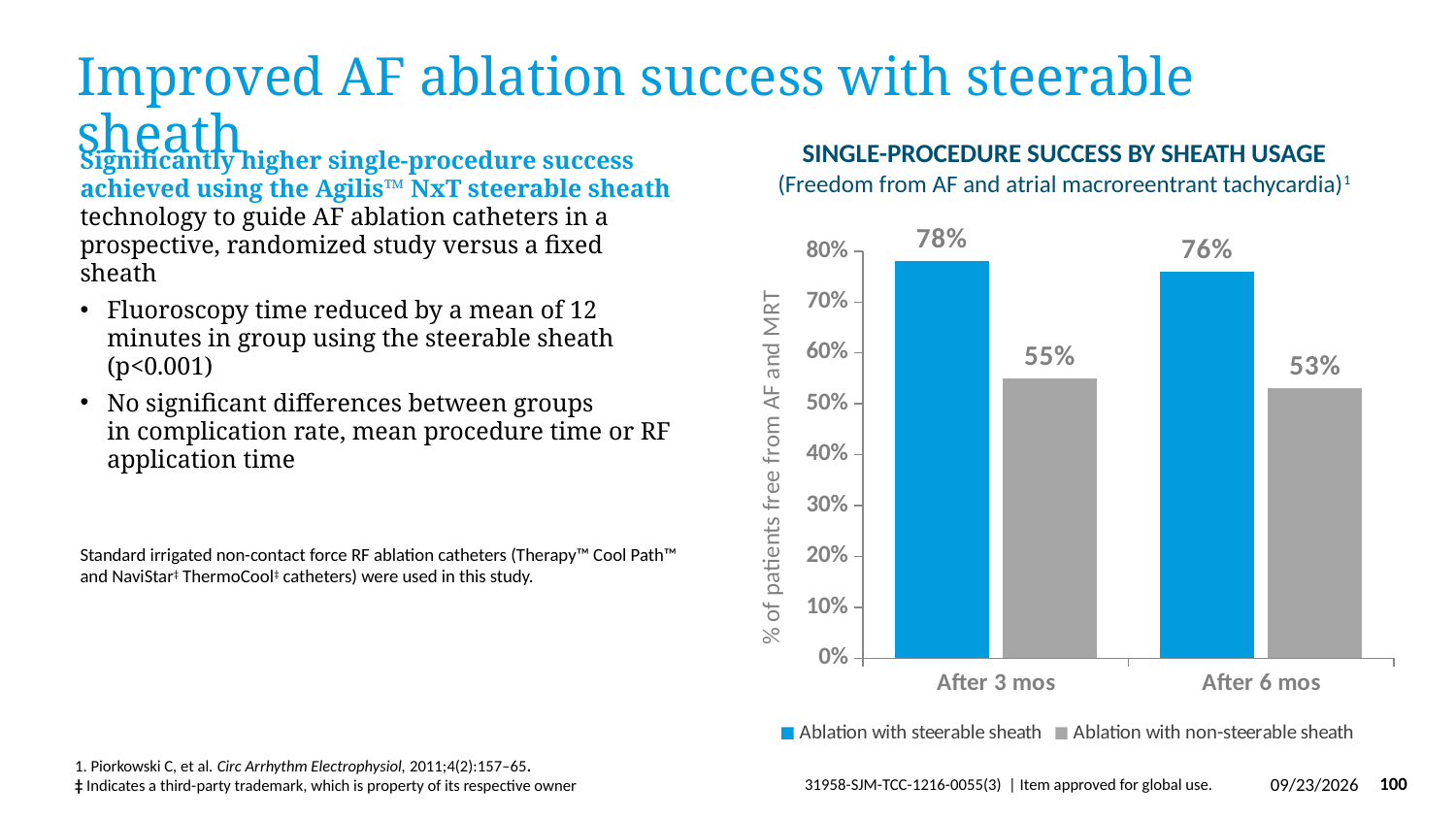
Which bar has the lowest value in the chart? Ablation with non-steerable sheath, After 6 mos What is the title of the chart? SINGLE-PROCEDURE SUCCESS BY SHEATH USAGE What is the value for ablation with steerable sheath after 3 months? 78% What is the value for ablation with non-steerable sheath after 6 months? 53% Which bar has the highest value in the chart? Ablation with steerable sheath, After 3 mos What is the value for ablation with non-steerable sheath after 3 months? 55% What is the difference between the steerable and non-steerable sheath values after 6 months? 23% How many categories are shown on the x axis? 2 What kind of chart is shown on the slide? Bar chart Which is larger after 6 months: ablation with steerable sheath or ablation with non-steerable sheath? Ablation with steerable sheath How many series does the legend list? 2 What is the difference between the steerable and non-steerable sheath values after 3 months? 23%